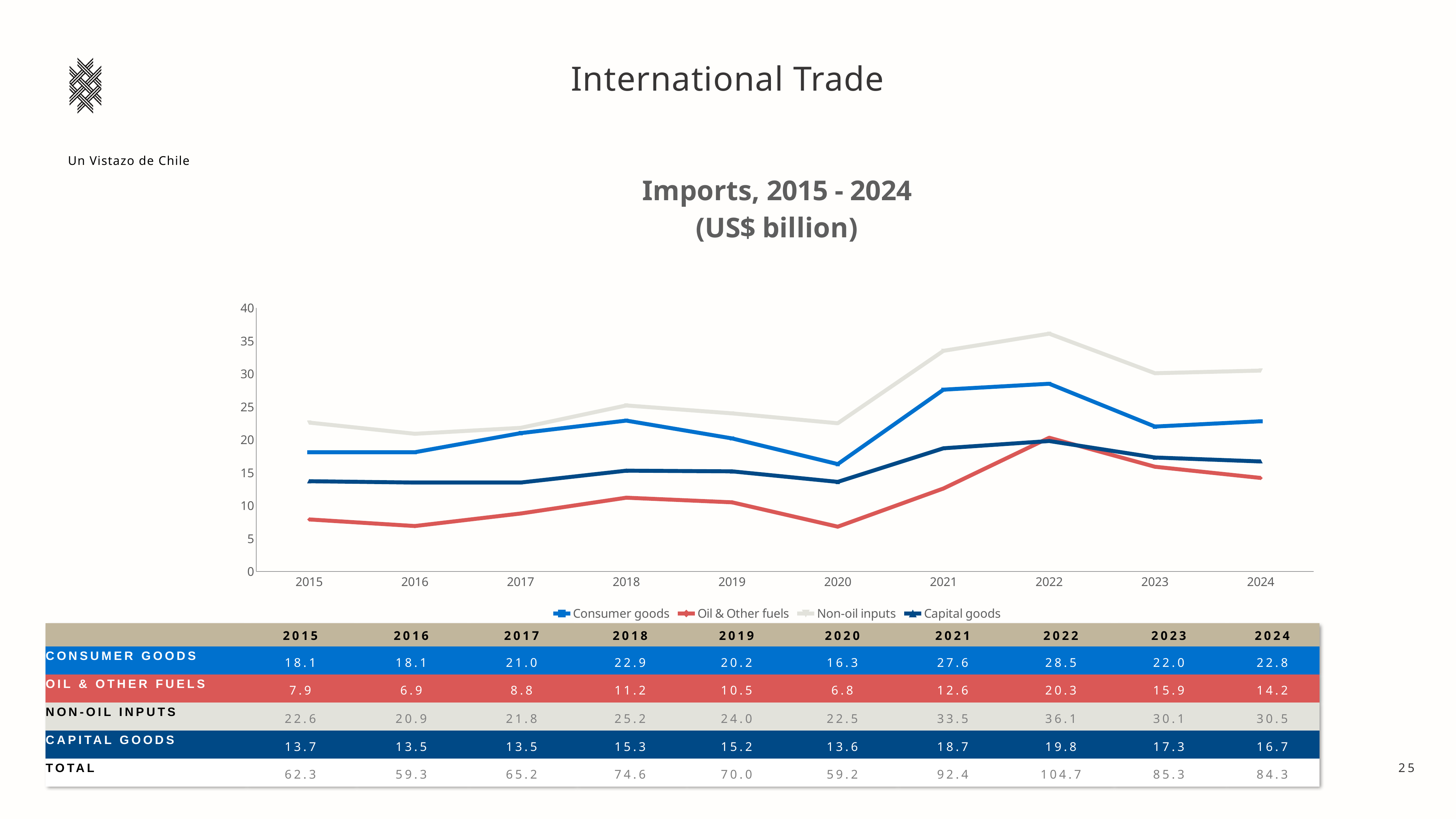
What is the difference between Consumer goods and Capital goods in 2021? 8.9 What is the value for Consumer goods in 2022? 28.5 In which year is Oil & Other fuels lowest? 2020 How many series does the legend list? 4 What is the title of the chart? Imports, 2015 - 2024 (US$ billion) What is the value for Non-oil inputs in 2024? 30.5 Do Non-oil inputs rise or fall from 2020 to 2022? Rise Which is larger in 2023: Oil & Other fuels or Capital goods? Capital goods What type of chart is shown on the slide? Line chart In which year is Non-oil inputs highest? 2022 How many years are plotted on the x axis? 10 What is the value for Oil & Other fuels in 2020? 6.8